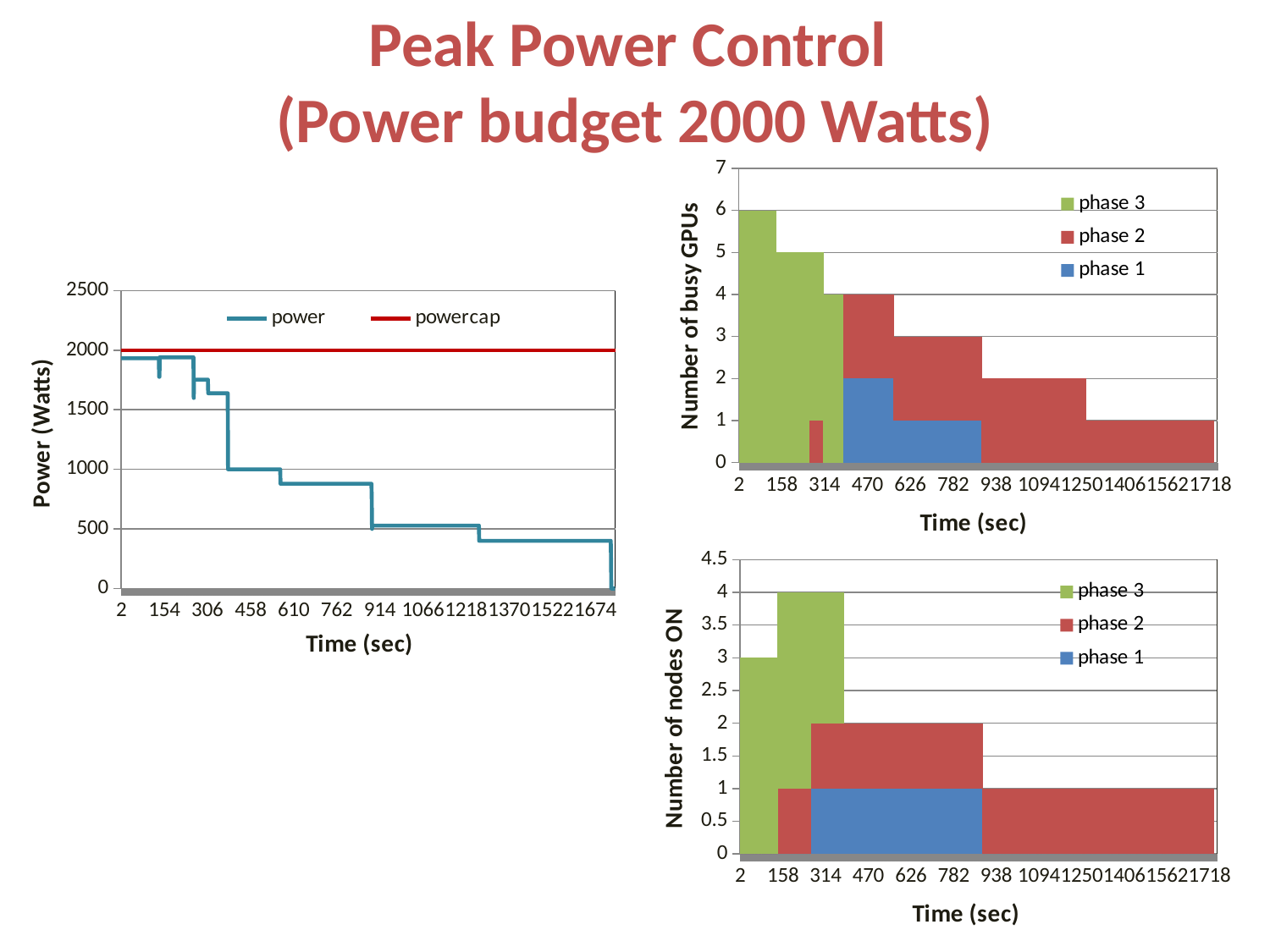
In the top-right chart (Number of busy GPUs), how many series does the legend list? 3 In the bottom-right chart (Number of nodes ON), what is the number of nodes ON at time 2? 3 In the left chart (Power (Watts) vs Time), is the power value at time 2 greater or less than 2000? less In the top-right chart (Number of busy GPUs), which phase is shown in green in the legend? phase 3 In the left chart (Power (Watts) vs Time), does the power series rise or fall over time? fall In the left chart (Power (Watts) vs Time), how many series does the legend list? 2 In the left chart (Power (Watts) vs Time), is the power value at time 1674 greater or less than 500? less In the left chart (Power (Watts) vs Time), what kind of chart is it? line chart In the left chart (Power (Watts) vs Time), what value does the powercap line sit at? 2000 In the top-right chart (Number of busy GPUs), what is the number of busy GPUs at time 2? 6 In the bottom-right chart (Number of nodes ON), what is the highest number of nodes ON reached? 4 How many charts are shown on the slide? 3